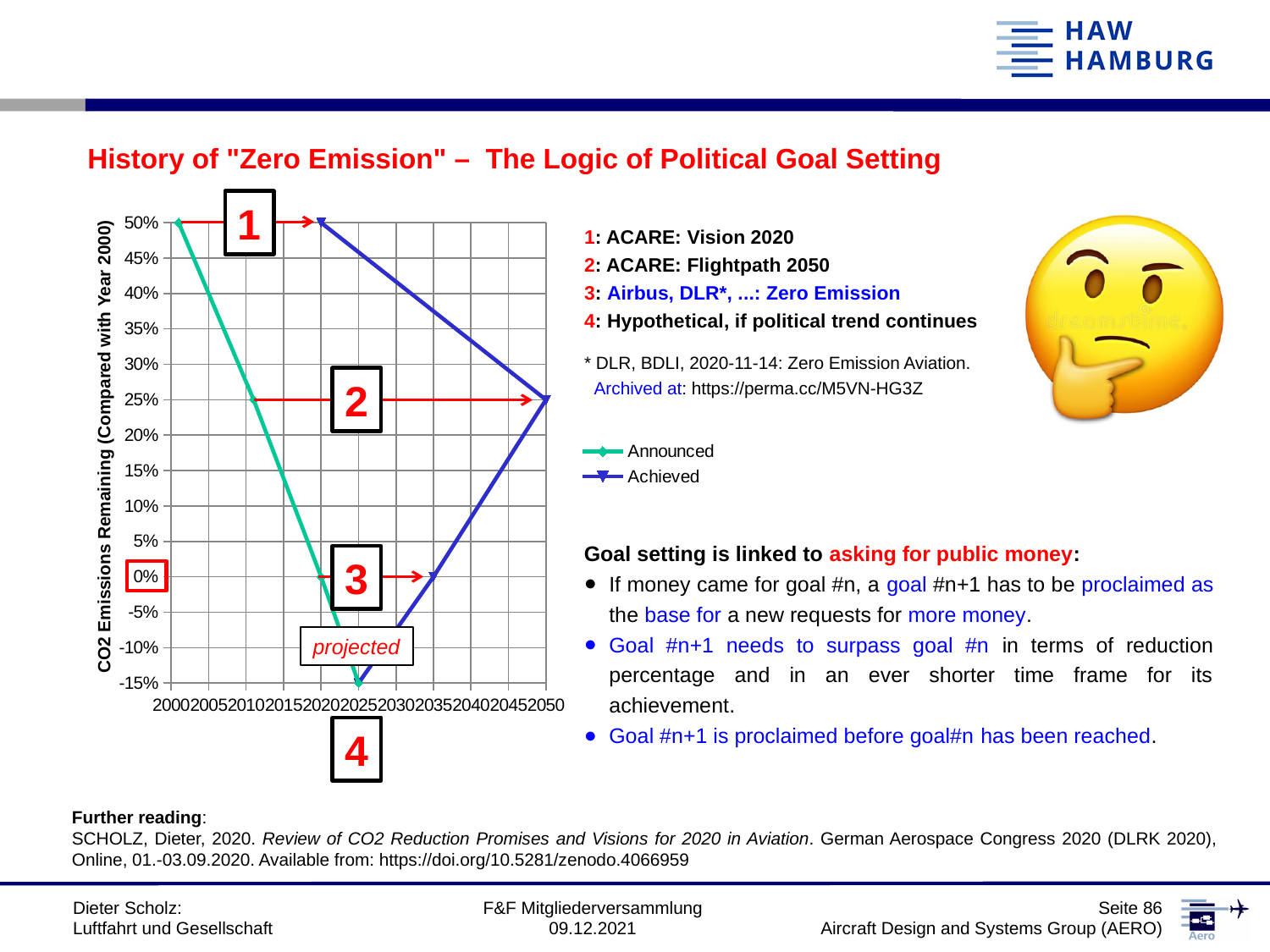
What are the two series named in the chart legend? Announced and Achieved Does the Announced series rise or fall as the years increase along the x axis? fall Is the value of the Announced series in 2005 greater or less than 30%? greater What kind of chart is shown on the slide? line chart What is the value of the Announced series in the year 2020? 0% In the year 2020, which series has the larger value, Announced or Achieved? Achieved What is the value of the Achieved series in the year 2050? 25% What is the value of the Announced series in the year 2000? 50% What is the title of the chart's vertical axis? CO2 Emissions Remaining (Compared with Year 2000) How many series does the chart legend list? 2 How many numbered goal markers (red boxes) are placed on the chart? 4